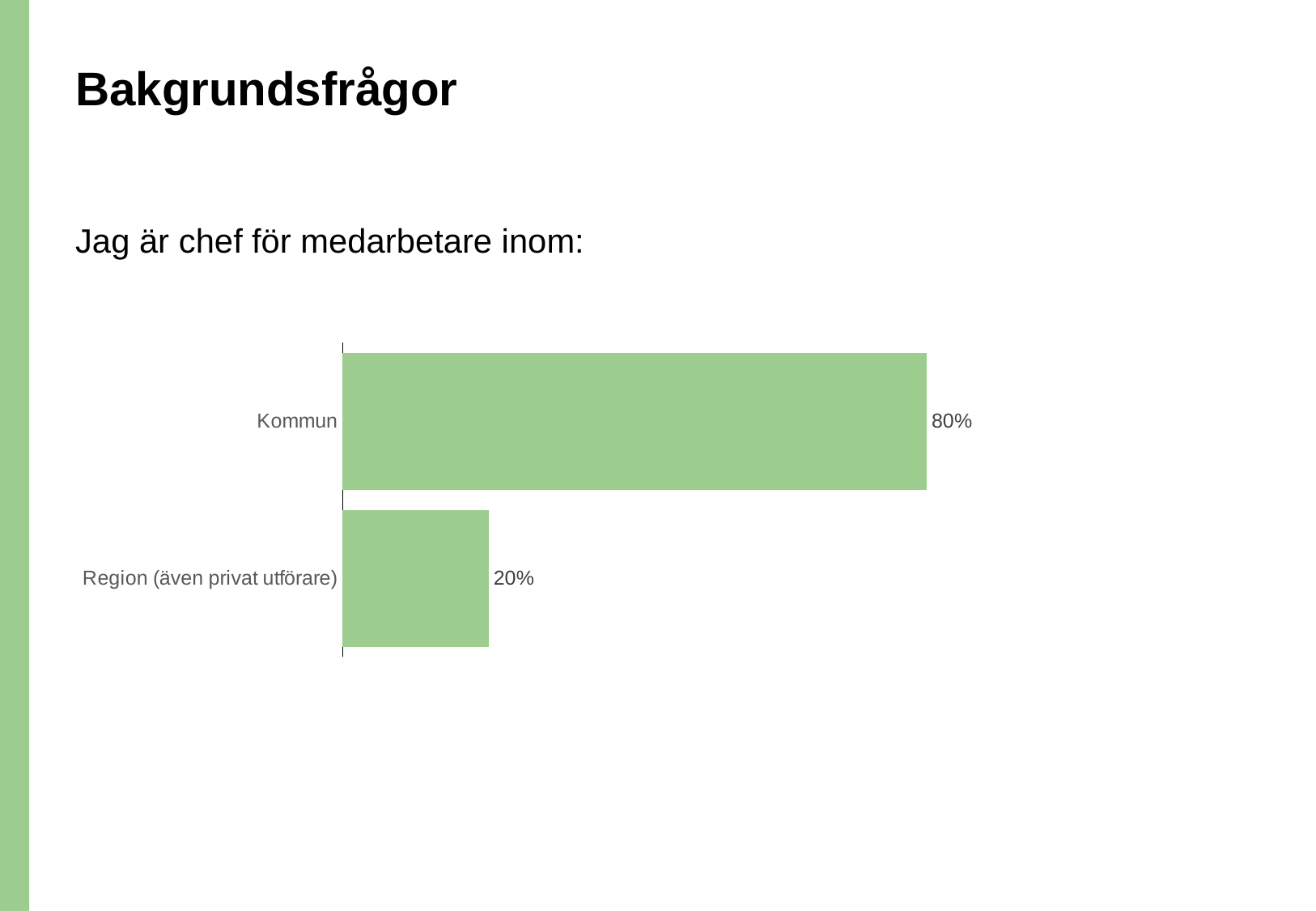
What question does the chart on the slide answer? Jag är chef för medarbetare inom: Which is larger, the value for Kommun or the value for Region (även privat utförare)? Kommun What is the value for Kommun? 80% What colour are the bars in the chart? Green What kind of chart is shown on the slide? Bar chart What is the value for Region (även privat utförare)? 20% Which category has the highest value? Kommun What is the difference between the values for Kommun and Region (även privat utförare)? 60% What is the total of the two values shown in the chart? 100% How many categories are shown in the chart? 2 Which category has the lowest value? Region (även privat utförare)